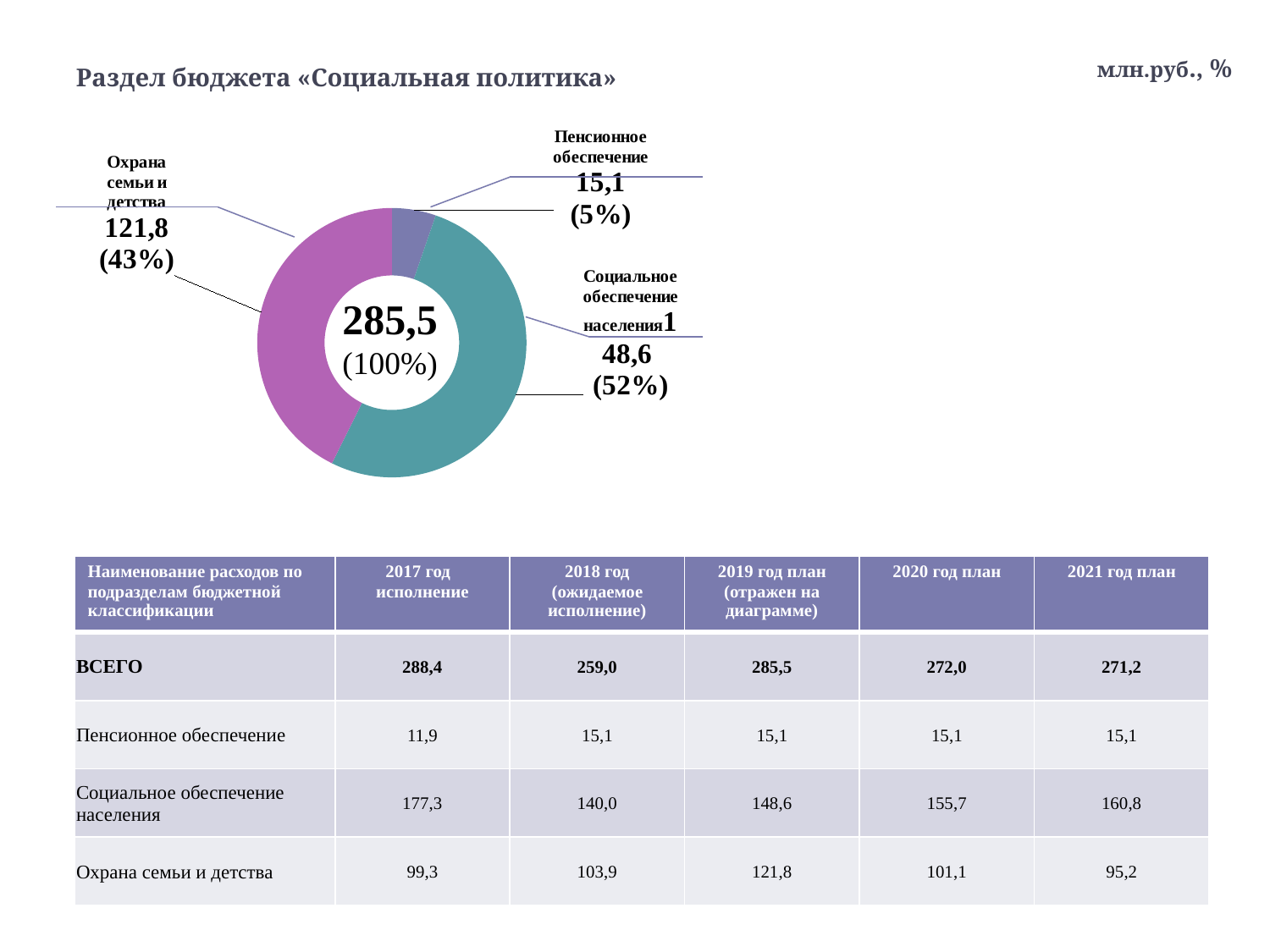
What value is shown in the centre of the donut chart? 285,5 What share of the donut chart does Социальное обеспечение населения take? 52% What is the difference between the values for Охрана семьи и детства and Пенсионное обеспечение on the donut chart? 106,7 What share of the donut chart does Охрана семьи и детства take? 43% What kind of chart is shown on the slide? Donut (pie) chart On the donut chart, which is larger: Охрана семьи и детства or Пенсионное обеспечение? Охрана семьи и детства Which slice of the donut chart is the largest? Социальное обеспечение населения How many slices does the donut chart have? 3 Which slice of the donut chart is the smallest? Пенсионное обеспечение What is the value for Пенсионное обеспечение on the donut chart? 15,1 What is the value for Охрана семьи и детства on the donut chart? 121,8 What share of the donut chart does Пенсионное обеспечение take? 5%